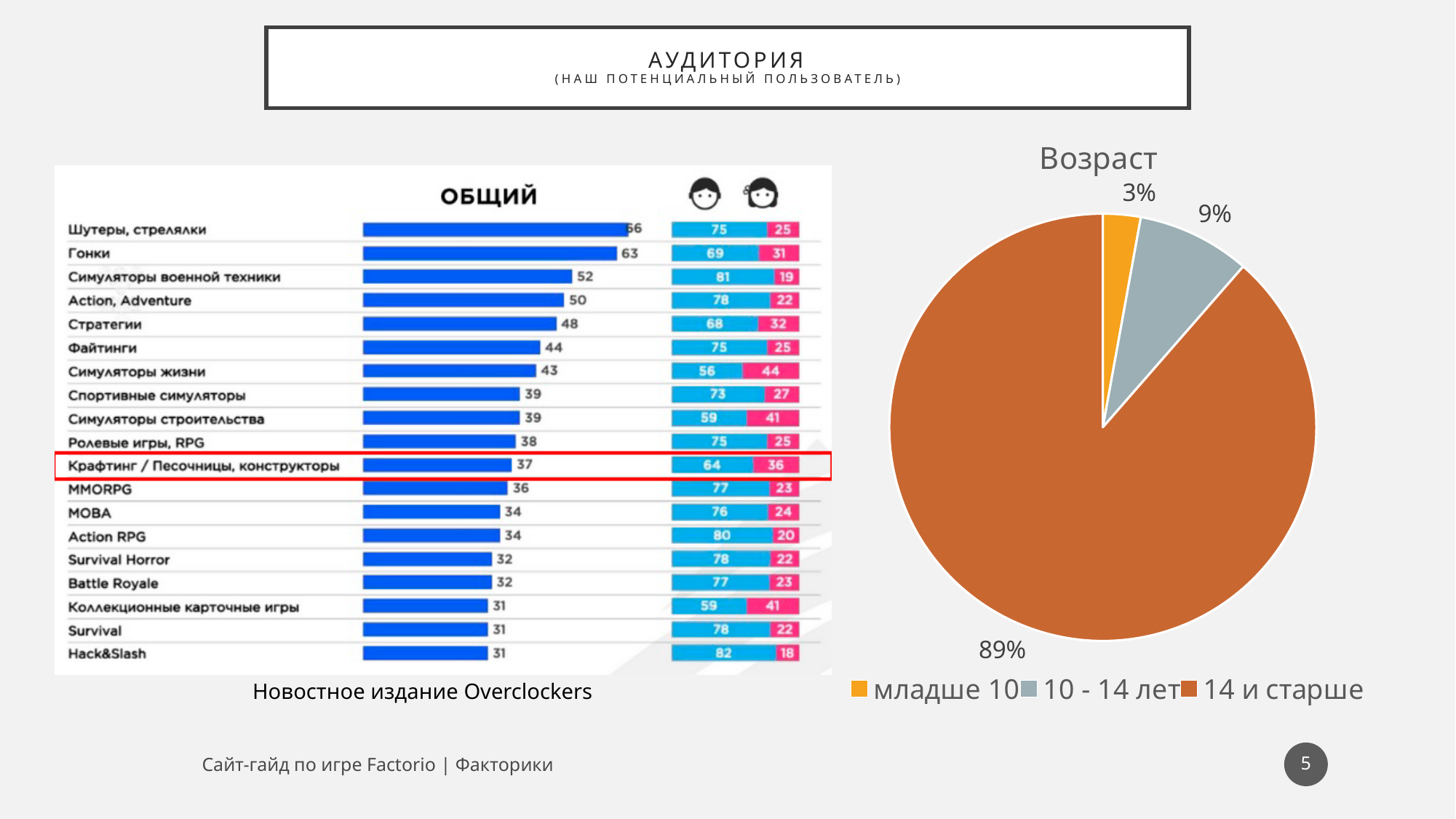
In the pie chart titled Возраст, what is the difference between the 10 - 14 лет share and the младше 10 share? 6% What kind of chart is the chart titled ОБЩИЙ on the left? bar chart In the pie chart titled Возраст, what share is shown for the 10 - 14 лет slice? 9% In the pie chart titled Возраст, which category has the smallest slice? младше 10 In the chart titled ОБЩИЙ on the left, what is the value for Стратегии? 48 In the chart titled ОБЩИЙ on the left, which is larger, the value for Файтинги or the value for MMORPG? Файтинги In the chart titled ОБЩИЙ on the left, what is the value for Крафтинг / Песочницы, конструкторы? 37 In the pie chart titled Возраст, which category has the largest slice? 14 и старше In the pie chart titled Возраст, what share is shown for the младше 10 slice? 3% In the chart titled ОБЩИЙ on the left, what is the value for Гонки? 63 In the pie chart titled Возраст, how many entries does the legend list? 3 In the pie chart titled Возраст, what share is shown for the 14 и старше slice? 89%